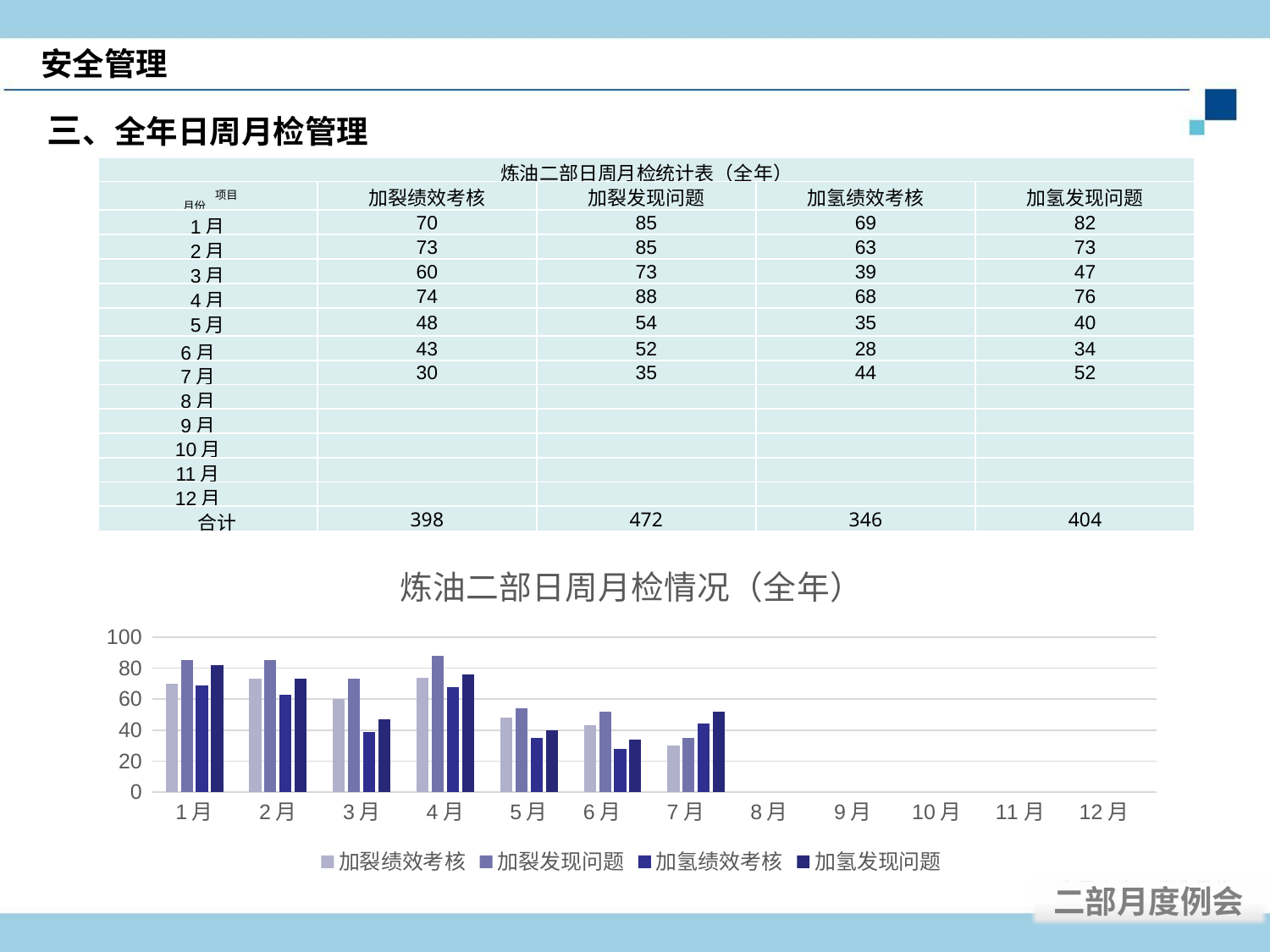
In which month is 加裂发现问题 highest? 4月 Does 加裂绩效考核 rise or fall from 4月 to 7月? fall What is the value of 加氢绩效考核 for 6月? 28 For how many months does the chart show plotted bars? 7 What is the difference between 加裂发现问题 and 加裂绩效考核 in 4月? 14 How many series does the legend of the chart list? 4 What kind of chart is shown under the title 炼油二部日周月检情况（全年）? bar chart In 7月, which is larger: 加裂绩效考核 or 加氢绩效考核? 加氢绩效考核 In which month is 加氢绩效考核 lowest? 6月 How many month categories are shown on the x axis of the chart? 12 Is the value of 加氢绩效考核 for 6月 greater or less than 40? less What is the value of 加裂发现问题 for 4月? 88